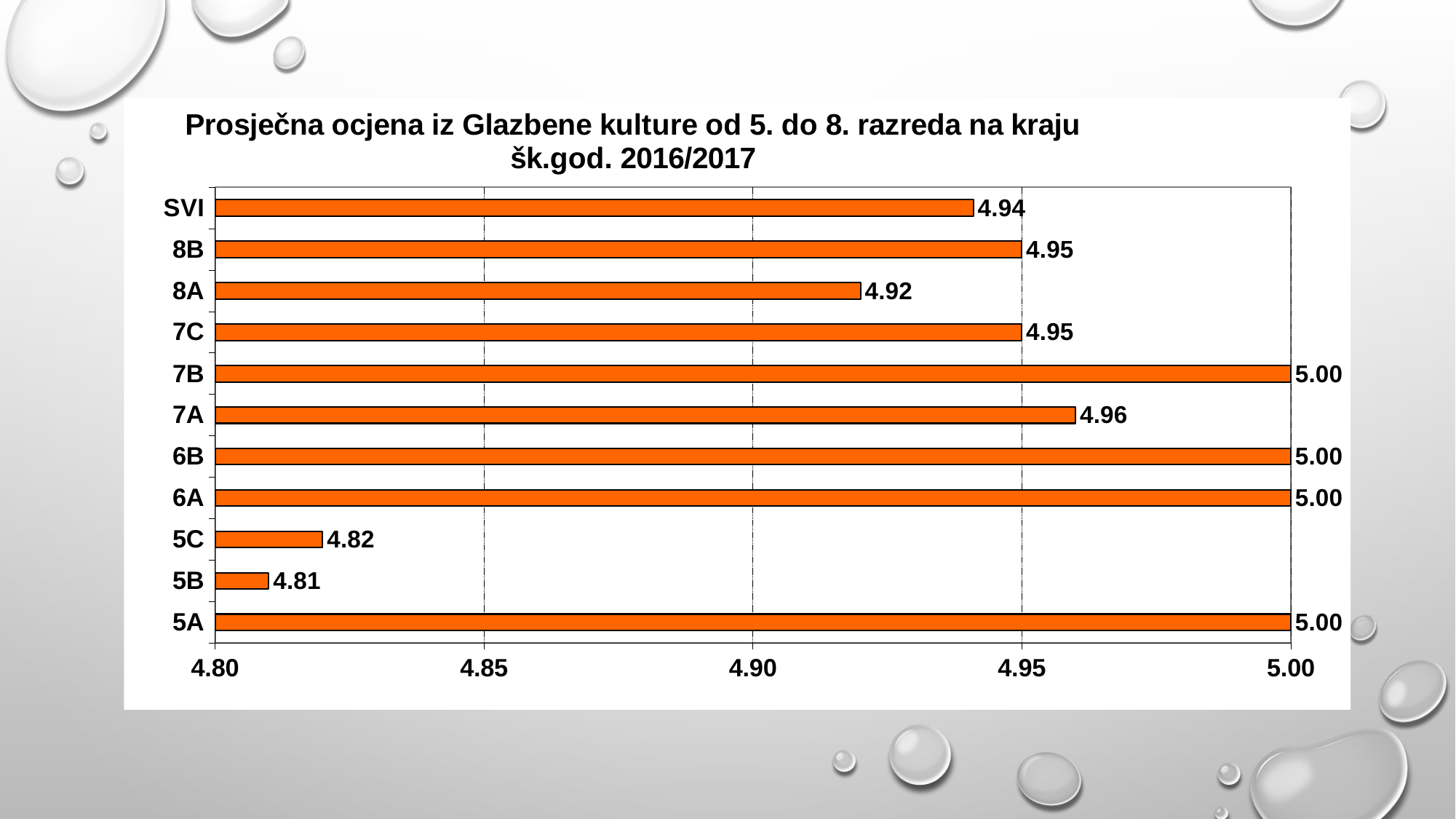
Which category has the lowest value? 5B What is the value for 8A? 4.92 What kind of chart is this? bar chart What is the value for 5C? 4.82 Which is larger, the value for 7A or the value for 8B? 7A Is the value for 5C greater or less than 4.85? less How many categories have a value of 5.00? 4 What is the difference between the values for 5A and 5B? 0.19 How many categories are shown on the chart? 11 What is the difference between the values for 7A and 8A? 0.04 What is the title of the chart? Prosječna ocjena iz Glazbene kulture od 5. do 8. razreda na kraju šk.god. 2016/2017 What is the value for SVI? 4.94